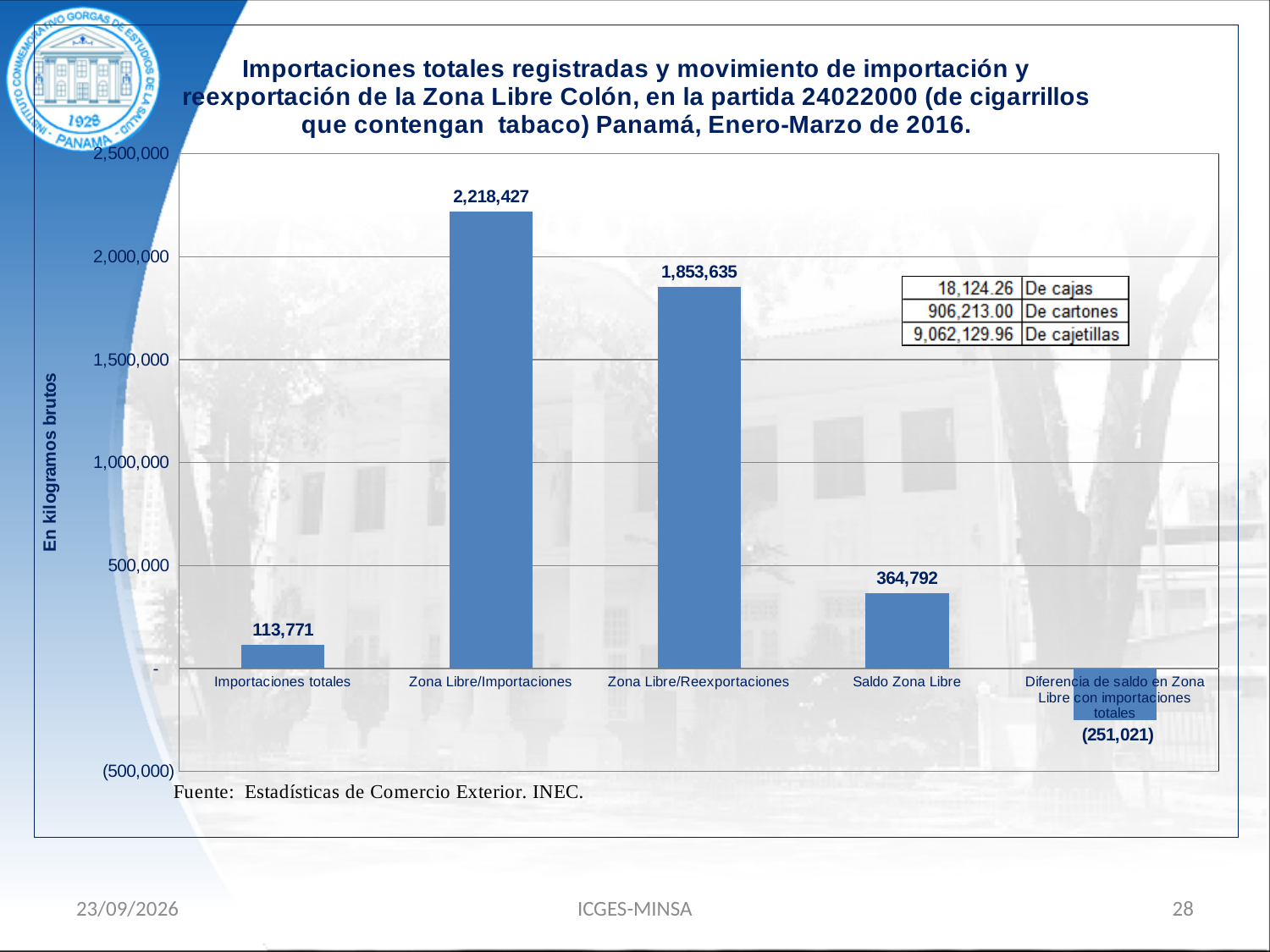
What is the value for Importaciones totales? 113,771 What is the value for Saldo Zona Libre? 364,792 What is the difference between Zona Libre/Importaciones and Zona Libre/Reexportaciones? 364,792 Which category has the highest value? Zona Libre/Importaciones Which is larger, Saldo Zona Libre or Importaciones totales? Saldo Zona Libre Which category has the lowest value? Diferencia de saldo en Zona Libre con importaciones totales What is the label of the vertical axis? En kilogramos brutos How many categories are shown on the x axis? 5 What is the value for Zona Libre/Reexportaciones? 1,853,635 What kind of chart is shown on the slide? Bar chart What is the value for Zona Libre/Importaciones? 2,218,427 What is the value for Diferencia de saldo en Zona Libre con importaciones totales? (251,021)